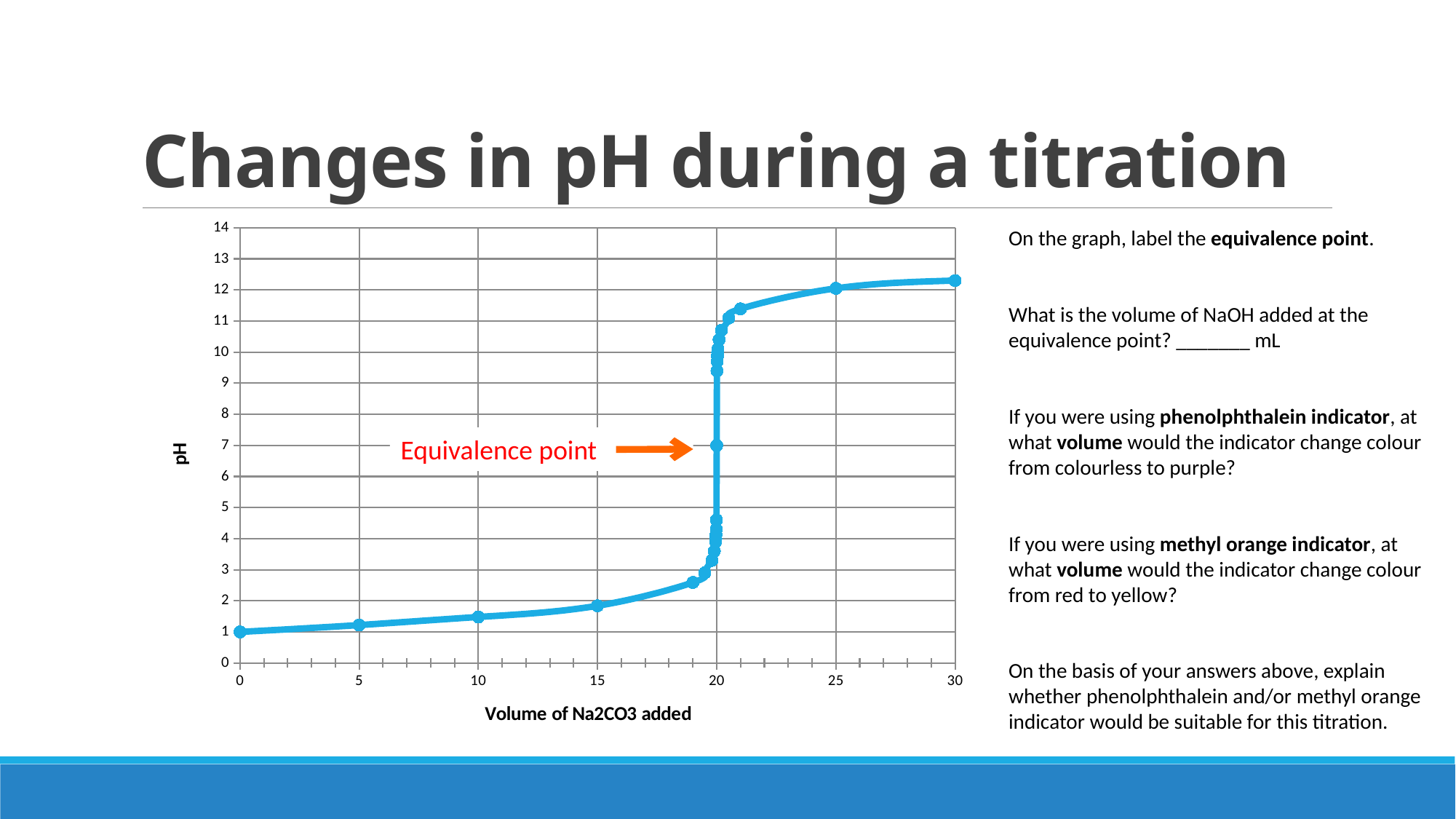
Which has the higher pH: a volume of 10 or a volume of 25? 25 Is the pH at a volume of 5 greater or less than 2? less Does the pH rise or fall as the volume of Na2CO3 added increases? Rises What kind of chart is shown on the slide? Line chart Is the pH at a volume of 15 greater or less than 3? less Is the pH at a volume of 30 greater or less than 11? greater What is the pH at the point labelled 'Equivalence point'? 7 What is the title of the y axis of the chart? pH At which volume of Na2CO3 added is the pH highest? 30 At what volume of Na2CO3 added does the point labelled 'Equivalence point' occur? 20 What is the title of the x axis of the chart? Volume of Na2CO3 added